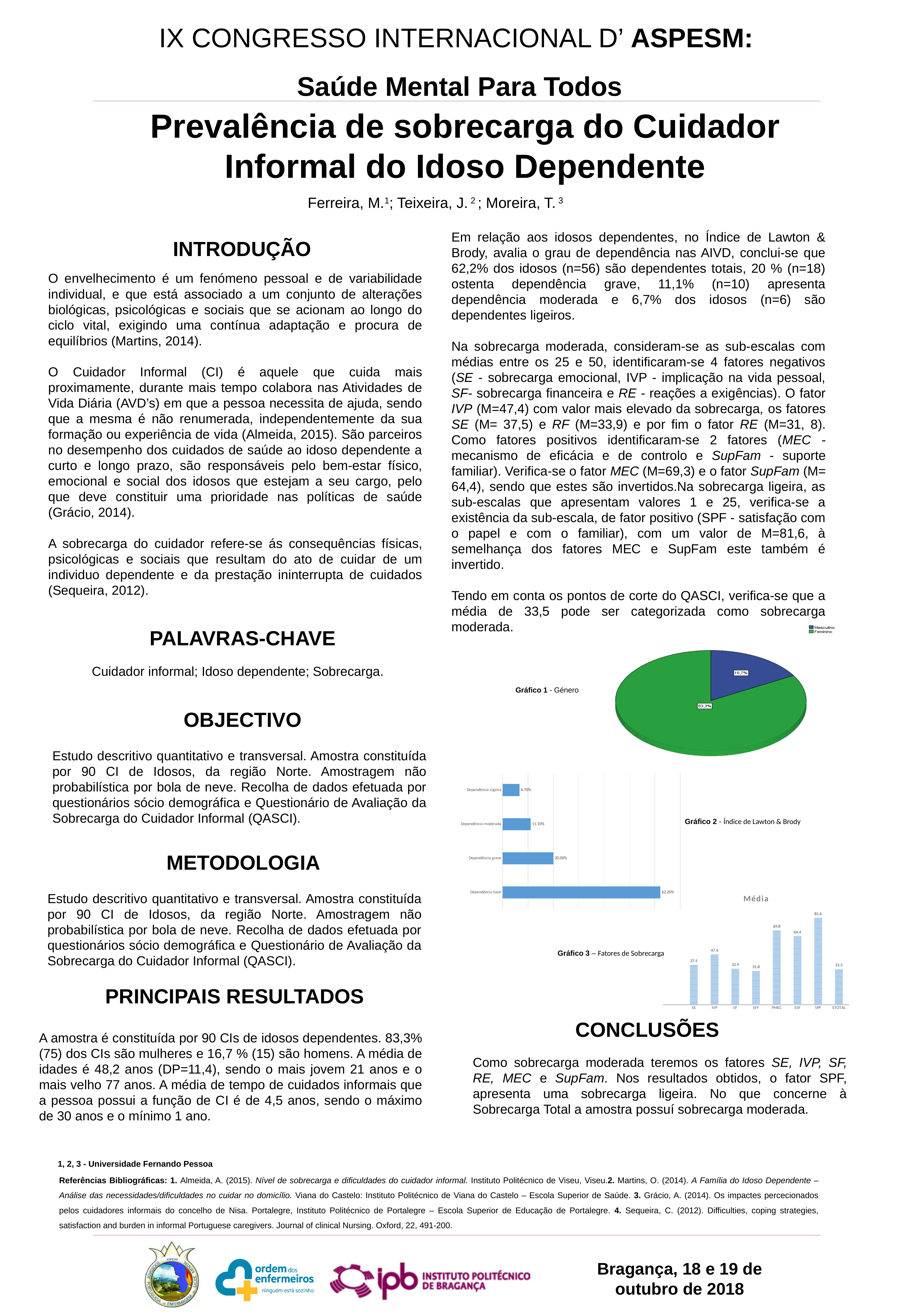
In Gráfico 3 – Fatores de Sobrecarga, which category has the highest value? SPF In Gráfico 2 - Índice de Lawton & Brody, what is the value for Dependência grave? 20.00% What kind of chart is Gráfico 1 - Género? Pie chart In Gráfico 3 – Fatores de Sobrecarga, what is the value for PMEC? 69.8 In Gráfico 3 – Fatores de Sobrecarga, which is larger, the value for IVP or the value for SE? IVP In Gráfico 2 - Índice de Lawton & Brody, how many categories are plotted? 4 In Gráfico 2 - Índice de Lawton & Brody, what is the difference between Dependência moderada and Dependência Ligeira? 4.40% In Gráfico 2 - Índice de Lawton & Brody, which category has the lowest value? Dependência Ligeira In Gráfico 2 - Índice de Lawton & Brody, what is the value for Dependência total? 62.20% In Gráfico 1 - Género, what percentage is shown for Feminino? 83,3% How many series does the legend of Gráfico 1 - Género list? 2 In Gráfico 1 - Género, what percentage is shown for Masculino? 16,7%